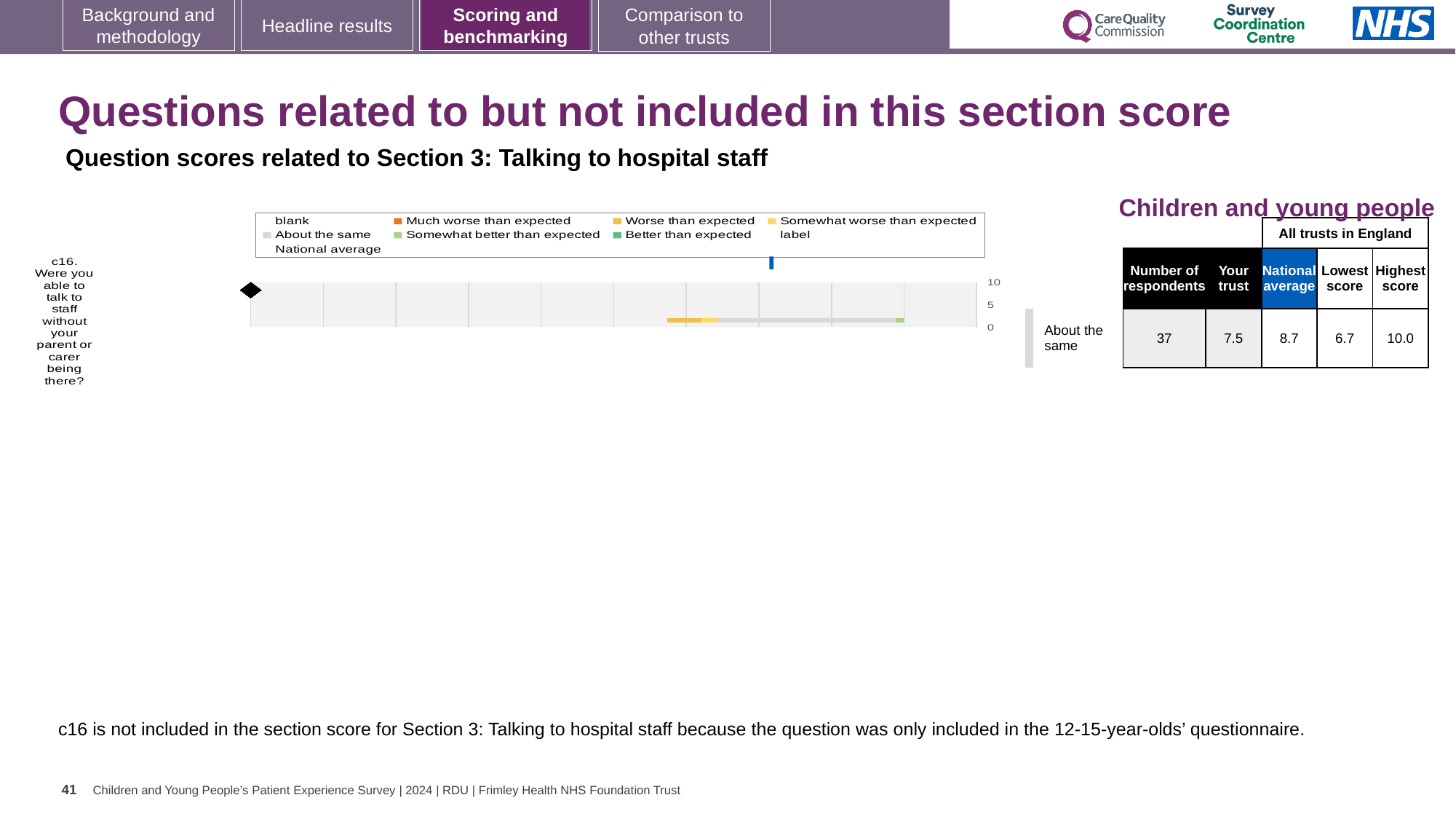
What colour does the legend use for 'Much worse than expected'? orange What is the highest tick value shown on the chart's score axis? 10 How many questions (categories) are plotted on the chart? 1 Which is larger for c16: the trust's score or the national average? National average What is the lowest score among all trusts in England for c16? 6.7 What kind of chart is shown for question c16? bar chart What is the highest score among all trusts in England for c16? 10.0 Which benchmark category is the trust's c16 result labelled as? About the same How many respondents answered question c16? 37 What is the difference between the national average and the trust's score for c16? 1.2 According to the table beside the chart, what is the national average score for c16? 8.7 According to the table beside the chart, what is the 'Your trust' score for c16? 7.5